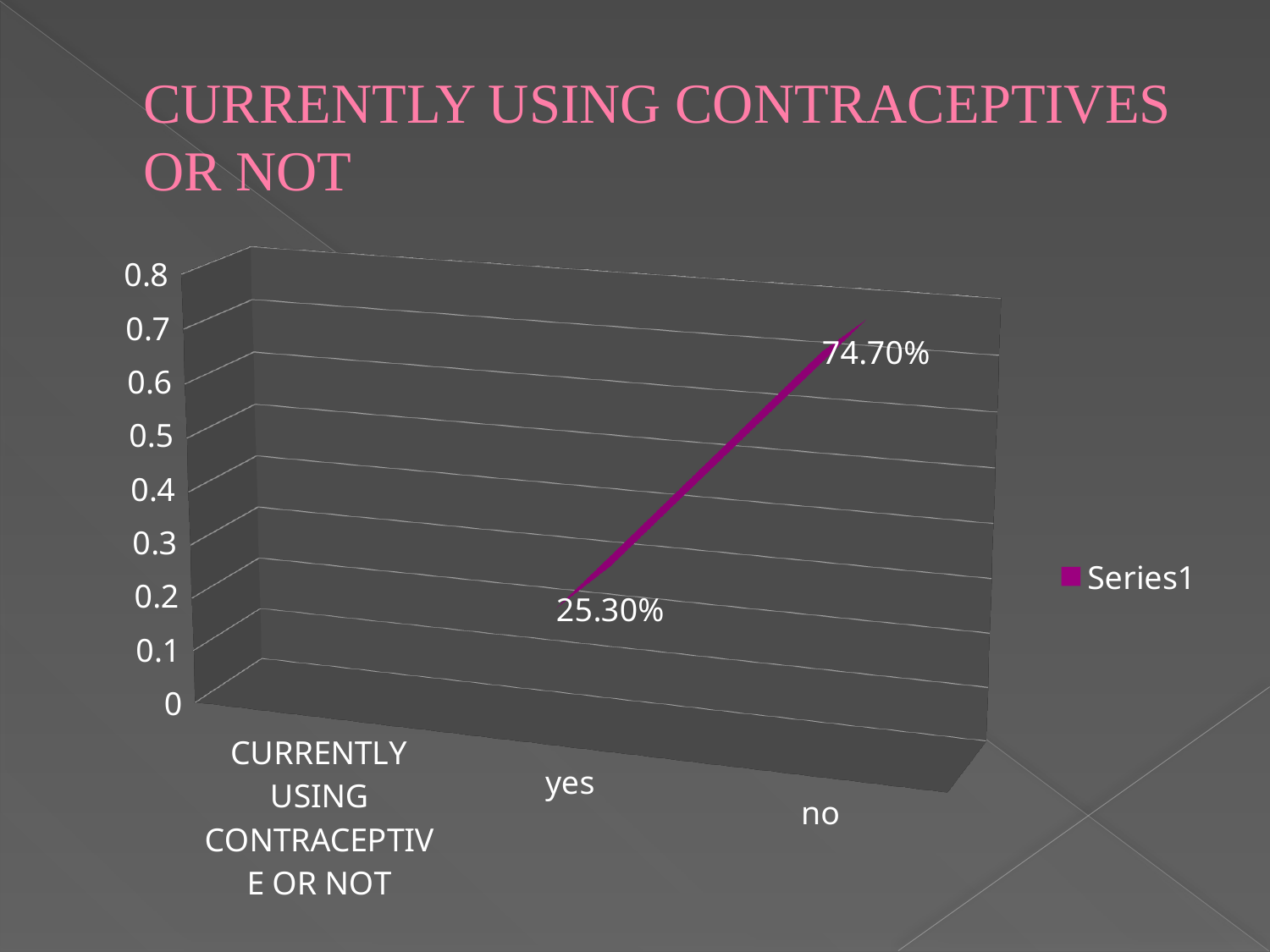
Which category has the lowest value? yes Is the value for "yes" greater or less than 0.3? less Does the line rise or fall from "yes" to "no"? rise What is the difference between the values for "no" and "yes"? 49.40% What kind of chart is shown on the slide? line chart What is the value for "yes"? 25.30% What is the value for "no"? 74.70% Is the value for "no" greater or less than 0.7? greater Which category has the highest value? no Which is larger, the value for "yes" or the value for "no"? no How many data points are labelled with values on the chart? 2 How many series does the legend list? 1